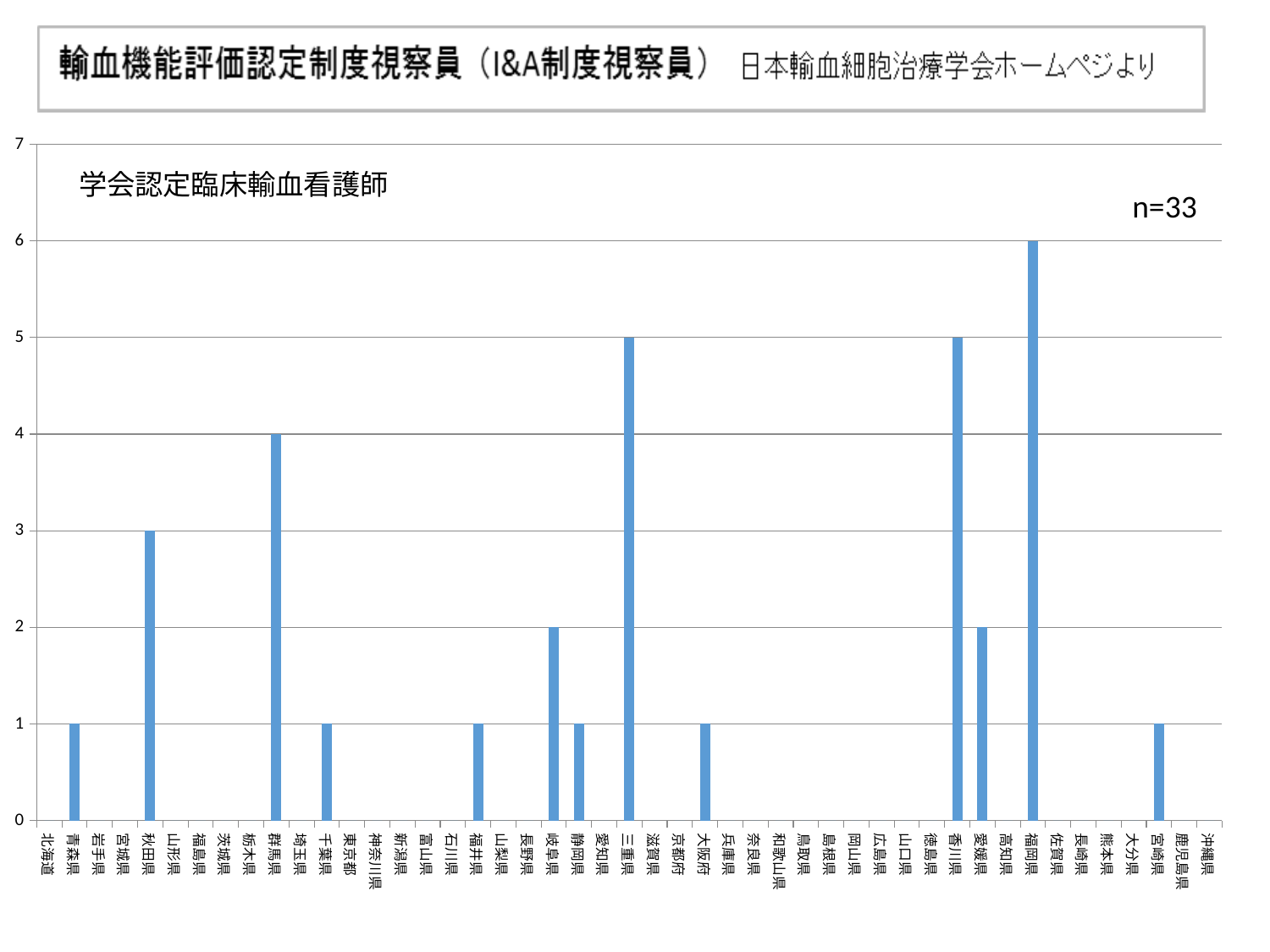
What type of chart is shown on the slide? bar chart Which is larger, the value for 群馬県 or the value for 岐阜県? 群馬県 What is the sample size (n) shown on the chart? n=33 What is the value for 愛媛県? 2 How many prefectures are listed on the x axis? 47 What is the difference between the values for 福岡県 and 香川県? 1 What is the value for 秋田県? 3 What is the value for 福岡県? 6 What is the value for 三重県? 5 What is the title text shown inside the chart area? 学会認定臨床輸血看護師 Which prefecture has the highest value in the chart? 福岡県 What is the value for 群馬県? 4